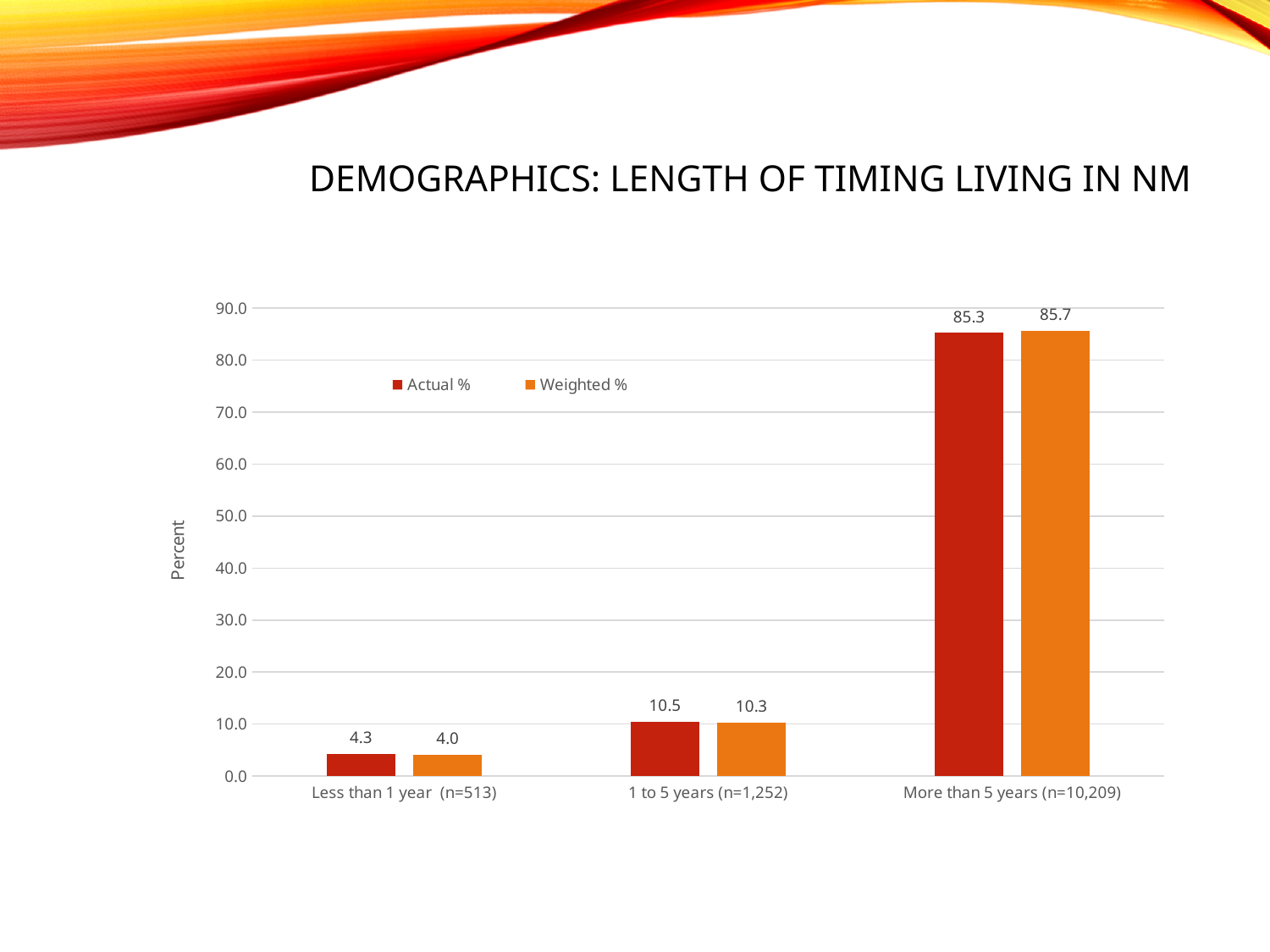
Which category has the lowest Weighted % value? Less than 1 year (n=513) What is the Weighted % value for 'More than 5 years (n=10,209)'? 85.7 What is the label of the y axis? Percent How many categories are shown on the x axis? 3 What is the Actual % value for 'Less than 1 year (n=513)'? 4.3 Is the Actual % value for 'More than 5 years (n=10,209)' greater or less than 80.0? greater What kind of chart is shown on the slide? Bar chart Which is larger for 'Less than 1 year (n=513)': the Actual % or the Weighted % value? Actual % What is the Weighted % value for '1 to 5 years (n=1,252)'? 10.3 What is the difference between the Actual % values for 'More than 5 years (n=10,209)' and '1 to 5 years (n=1,252)'? 74.8 Which category has the highest Actual % value? More than 5 years (n=10,209) How many series does the legend list? 2